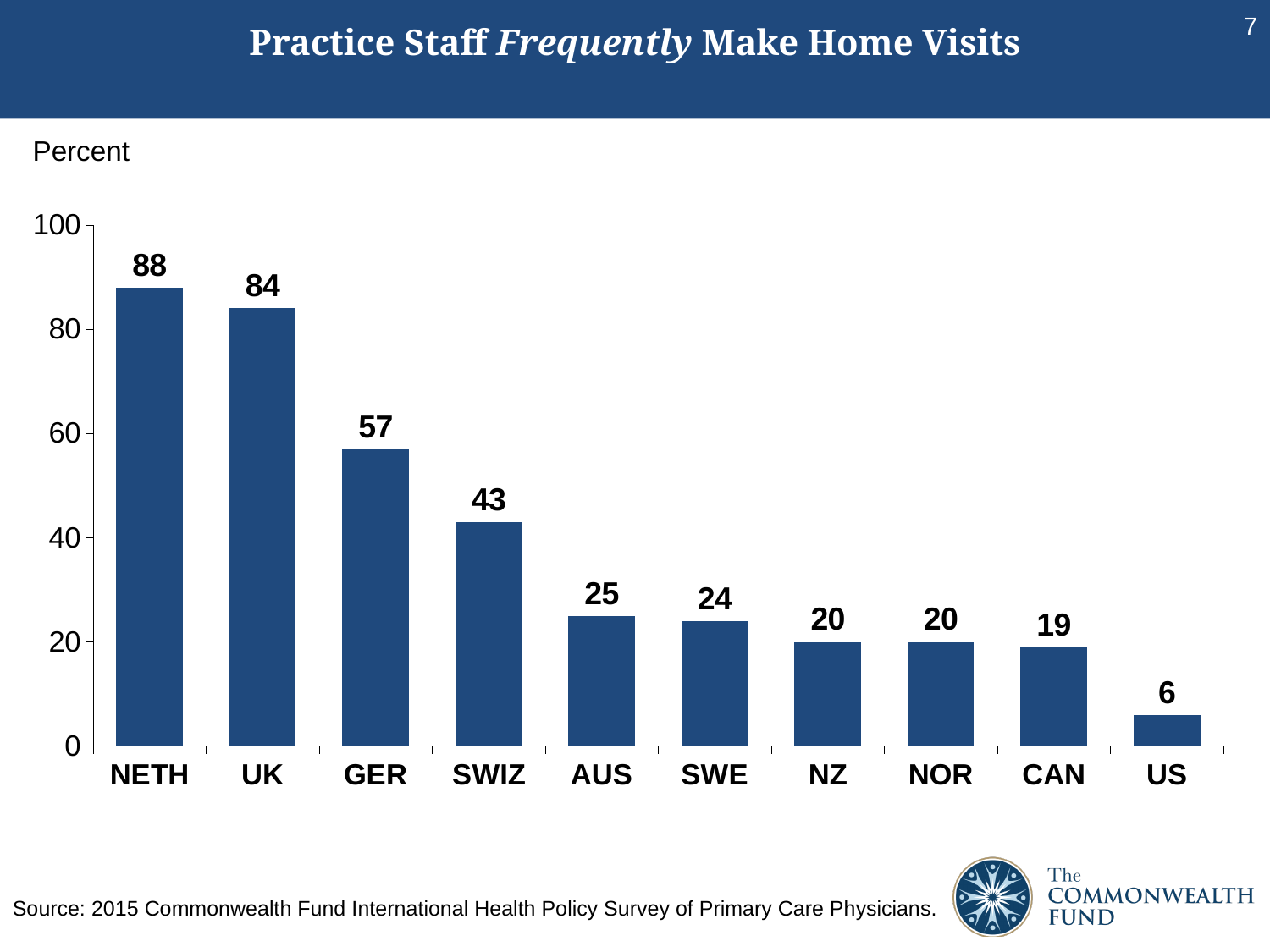
Which country has the lowest value? US What is the value for NETH? 88 What is the value for CAN? 19 What is the difference between the values for GER and SWIZ? 14 What kind of chart is shown on the slide? bar chart What is the title of the chart? Practice Staff Frequently Make Home Visits Which is larger, the value for AUS or the value for NOR? AUS What is the difference between the values for UK and US? 78 Is the value for GER greater or less than 60? less How many countries are shown on the chart? 10 Which country has the highest value? NETH What is the value for SWIZ? 43